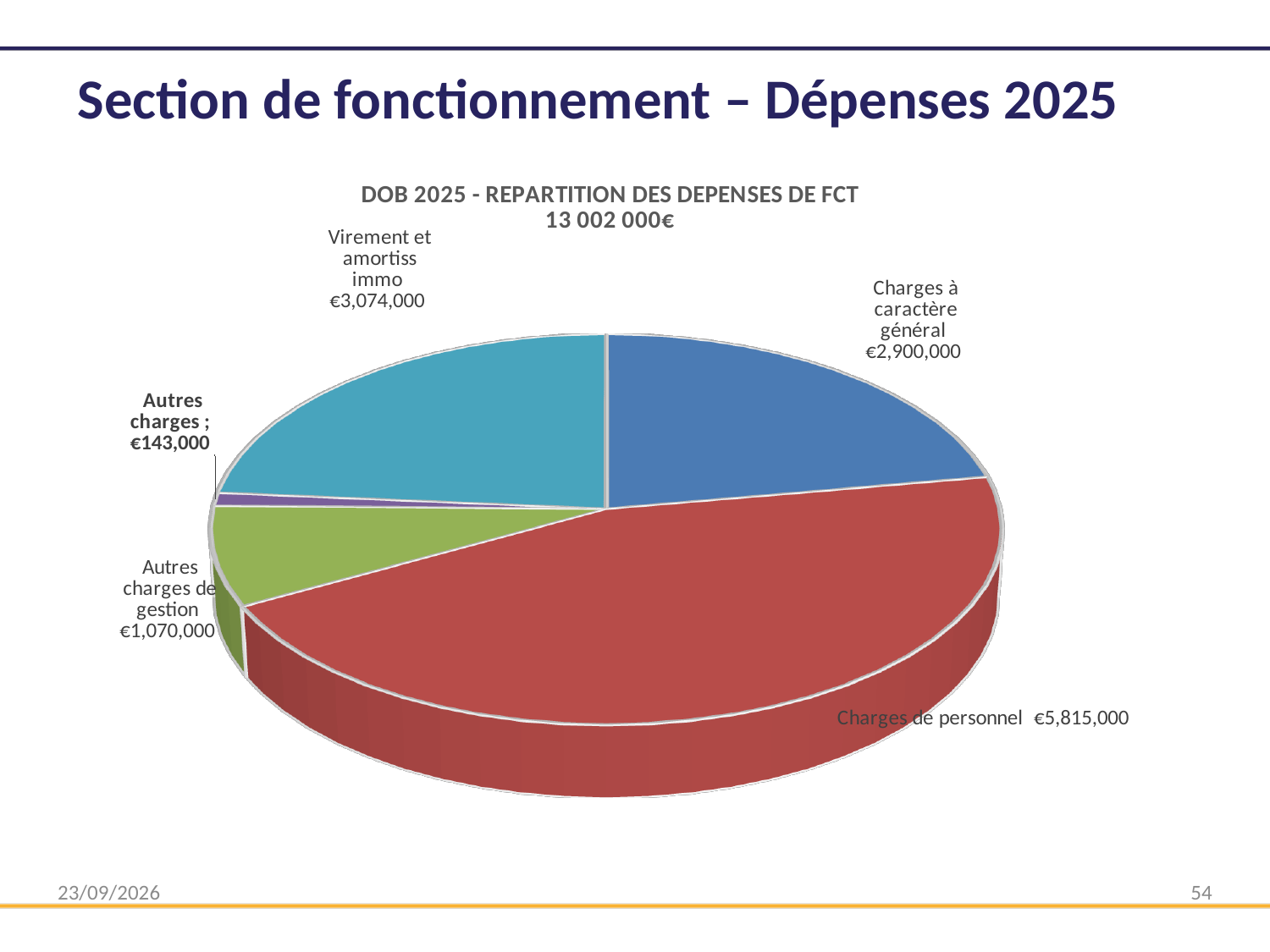
What is the value for Virement et amortiss immo? €3,074,000 Which category has the largest slice of the pie? Charges de personnel Which is larger, Virement et amortiss immo or Charges à caractère général? Virement et amortiss immo What total amount is stated in the chart title? 13 002 000€ What is the value for Autres charges? €143,000 What is the value for Charges de personnel? €5,815,000 Which category has the smallest slice of the pie? Autres charges What is the value for Charges à caractère général? €2,900,000 What is the value for Autres charges de gestion? €1,070,000 What is the difference between Charges de personnel and Charges à caractère général? €2,915,000 What type of chart is shown on the slide? Pie chart How many slices does the pie chart have? 5